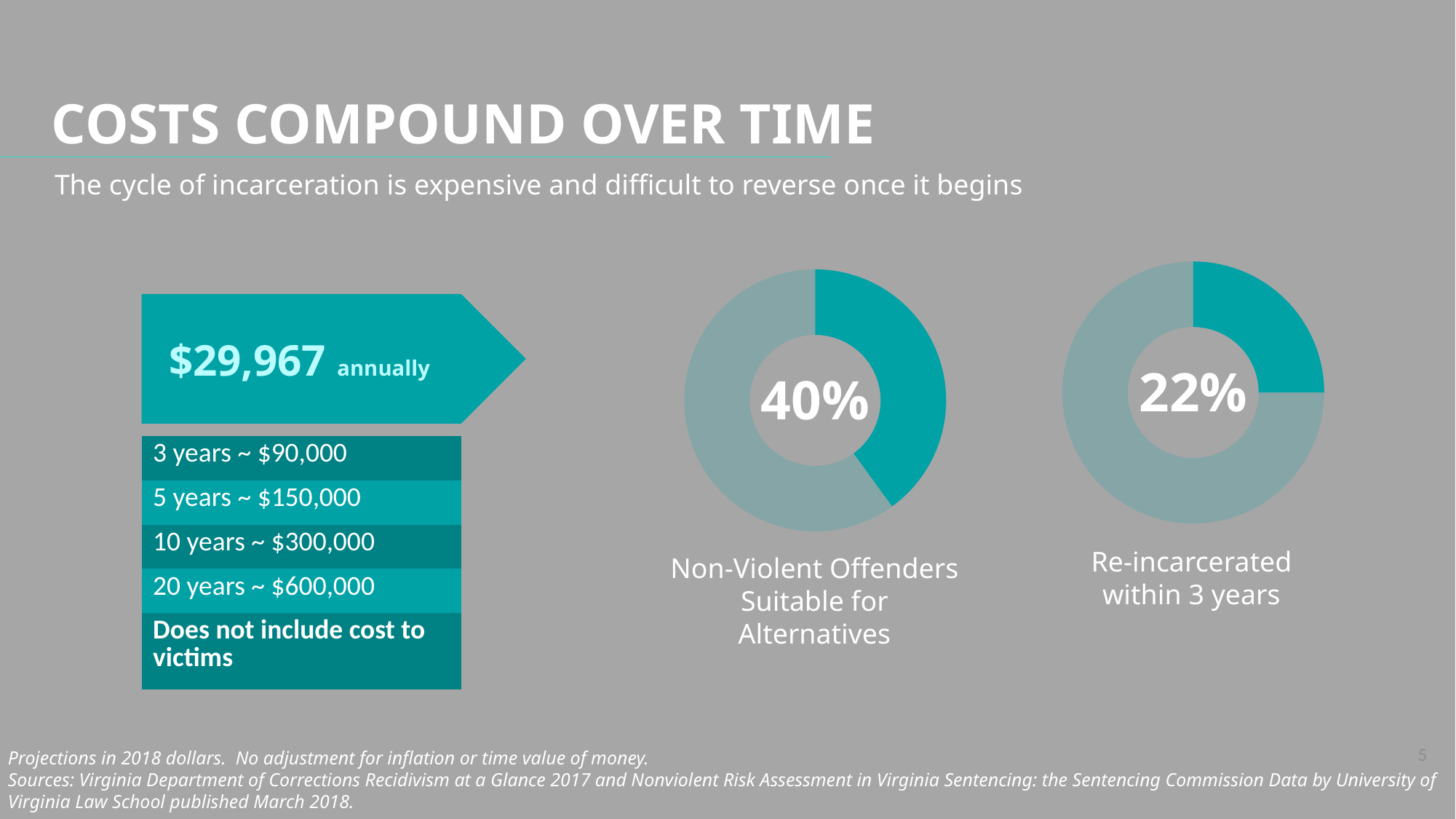
How many donut charts are shown on the slide? 2 In the Non-Violent Offenders Suitable for Alternatives donut chart, what share of the ring is highlighted in teal? 40% What kind of chart is used to show the 40% figure for Non-Violent Offenders Suitable for Alternatives? Donut (pie) chart Which donut chart shows the smaller highlighted share: Non-Violent Offenders Suitable for Alternatives or Re-incarcerated within 3 years? Re-incarcerated within 3 years What percentage is shown in the donut chart labelled "Non-Violent Offenders Suitable for Alternatives"? 40% What percentage is shown in the donut chart labelled "Re-incarcerated within 3 years"? 22% What colour is used for the highlighted segment in both donut charts? Teal Which donut chart shows the larger highlighted share: Non-Violent Offenders Suitable for Alternatives or Re-incarcerated within 3 years? Non-Violent Offenders Suitable for Alternatives What kind of chart is used to show the 22% figure for Re-incarcerated within 3 years? Donut (pie) chart What is the difference in percentage points between the 40% shown for Non-Violent Offenders Suitable for Alternatives and the 22% shown for Re-incarcerated within 3 years? 18 percentage points